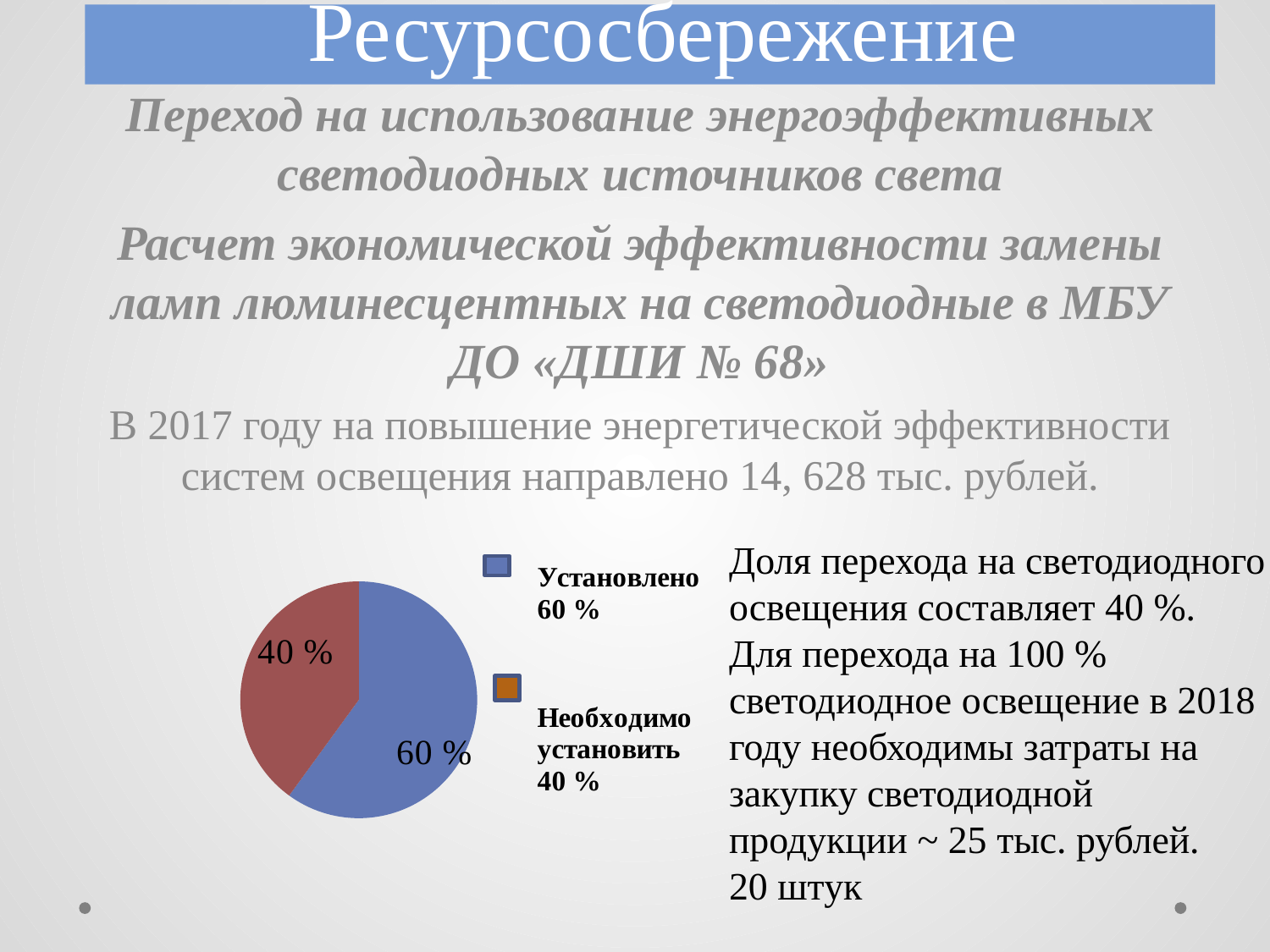
Which slice of the pie chart is the smallest? Необходимо установить How many slices does the pie chart have? 2 Which is larger: the "Установлено" slice or the "Необходимо установить" slice? Установлено What share of the pie does the slice "Необходимо установить" represent? 40 % Which slice of the pie chart is the largest? Установлено What is the total of the two slices shown in the pie chart? 100 % What colour is the "Установлено" slice in the pie chart? blue What colour is the "Необходимо установить" slice in the pie chart? red What kind of chart is shown on the slide? pie chart How many entries does the legend of the pie chart list? 2 What share of the pie does the slice "Установлено" represent? 60 % What is the difference in percentage points between the "Установлено" slice and the "Необходимо установить" slice? 20 %